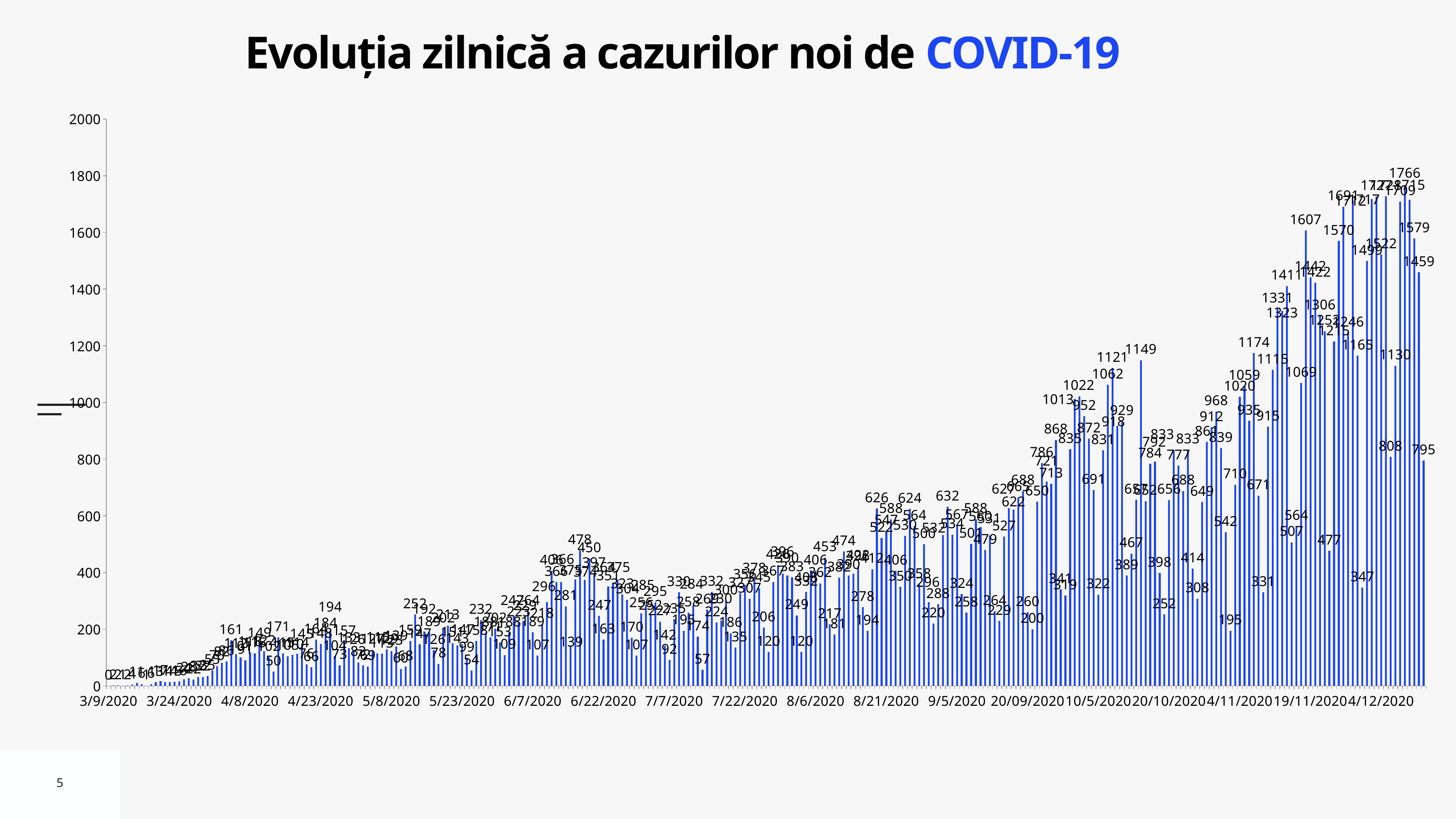
Is the value for 6/22/2020 greater or less than 1000? less Is the value for 3/24/2020 greater or less than 200? less What is the title of the chart? Evoluția zilnică a cazurilor noi de COVID-19 Overall, do the daily values rise or fall from left to right along the x axis? rise What is the highest daily value labelled on the chart? 1766 What is the maximum value shown on the y axis? 2000 Is the highest bar on the chart greater or less than 1800? less Which has the higher bars: the dates around 3/24/2020 or the dates around 10/5/2020? 10/5/2020 What is the difference between the highest labelled value, 1766, and the last bar's value, 795? 971 What is the value of the rightmost (last) bar on the chart? 795 What kind of chart is shown on the slide? bar chart